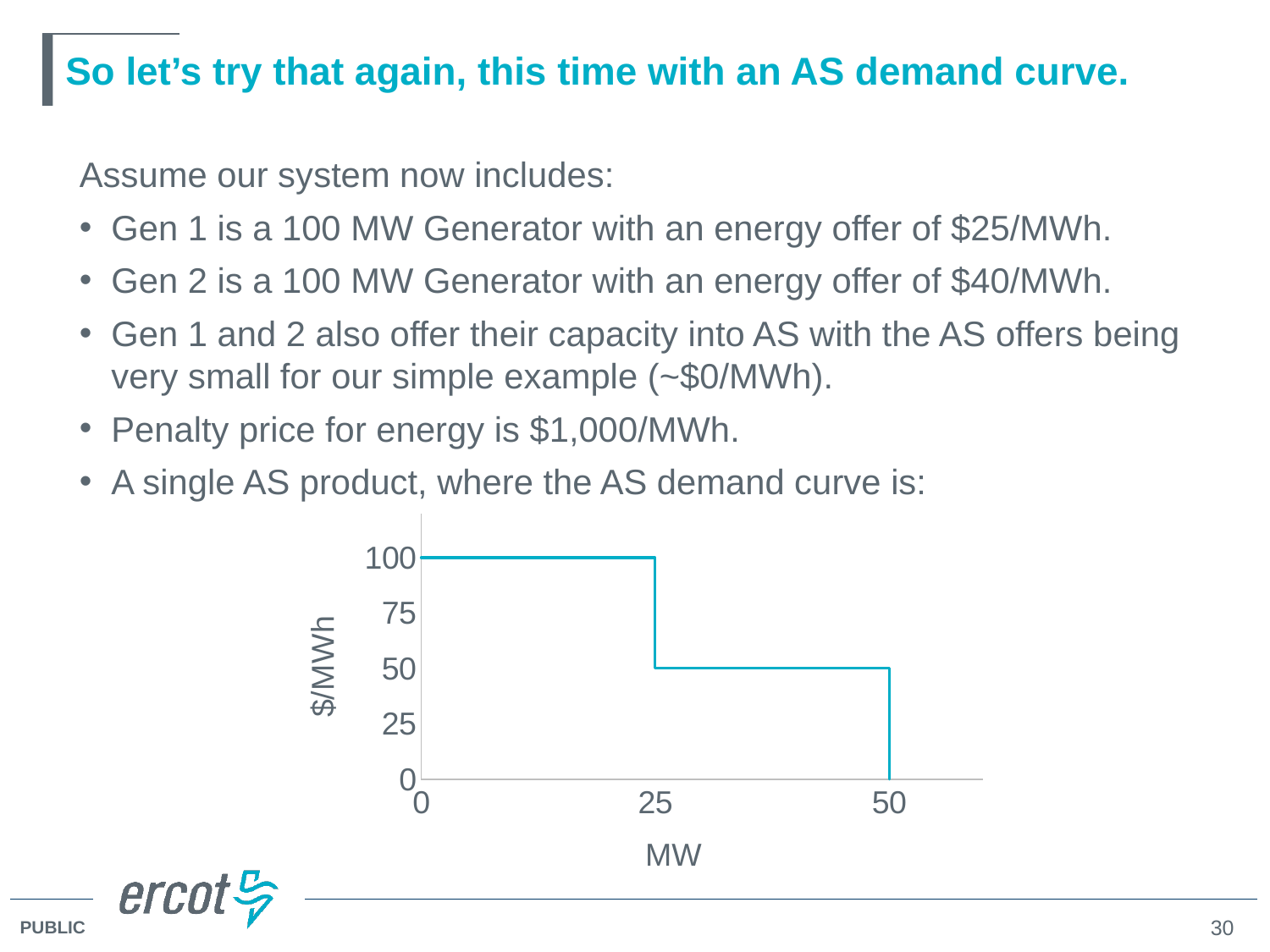
Is the $/MWh value of the curve at 40 MW greater or less than 75? less What is the difference in $/MWh between the first step (0–25 MW) and the second step (25–50 MW) of the curve? 50 What is the label of the x axis of the chart? MW At what MW value does the AS demand curve first step down from 100 $/MWh? 25 What is the $/MWh value of the AS demand curve between 0 and 25 MW? 100 What is the highest $/MWh value on the AS demand curve? 100 At what MW value does the AS demand curve drop to 0 $/MWh? 50 Which is larger: the $/MWh value at 10 MW or the $/MWh value at 40 MW? 10 MW What is the $/MWh value of the AS demand curve between 25 and 50 MW? 50 What type of chart is shown on the slide? line chart Does the AS demand curve rise or fall as MW increases along the x axis? fall What is the label of the y axis of the chart? $/MWh